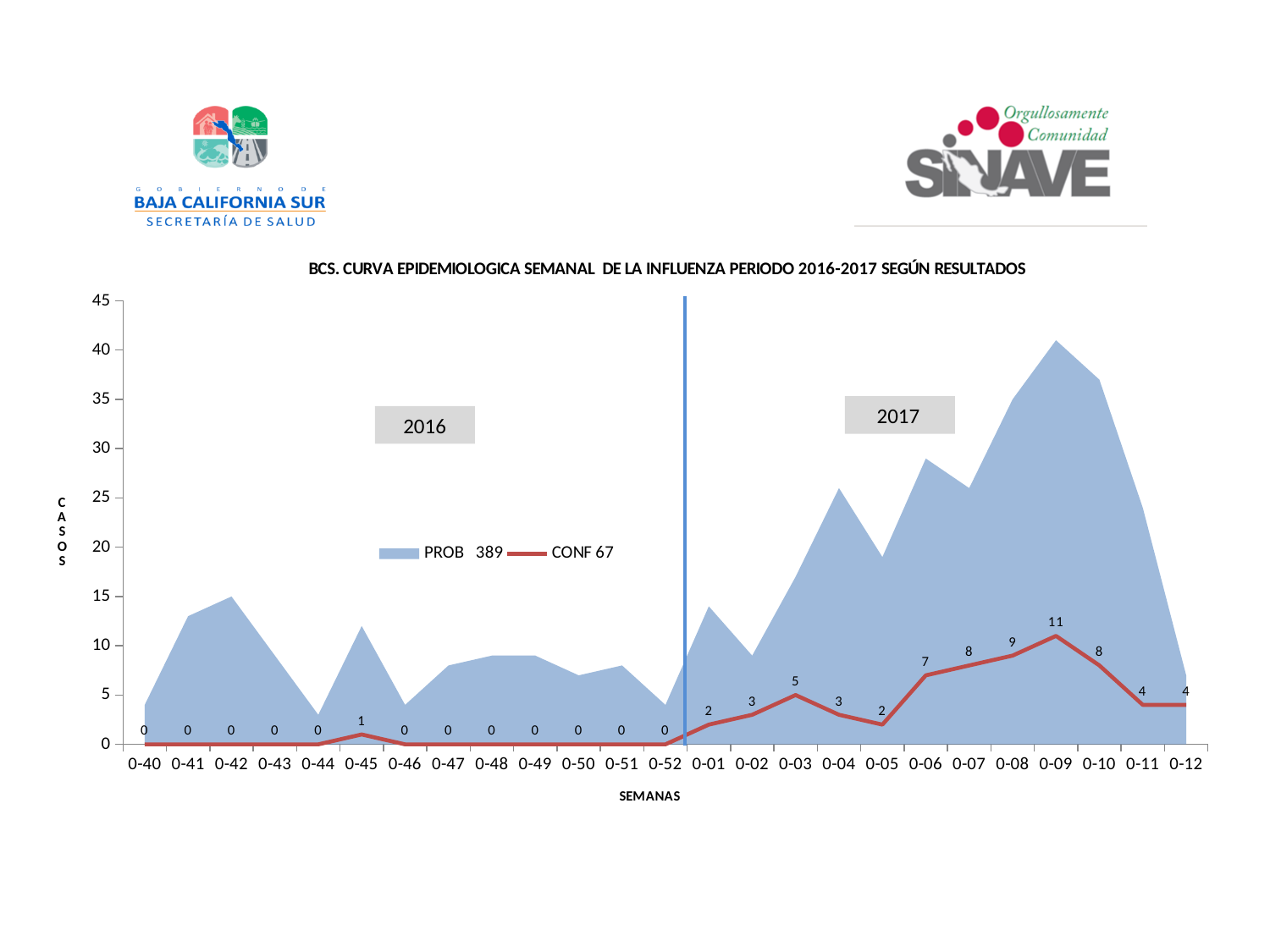
How many weeks are shown on the x axis? 25 How many series does the legend list? 2 Is the PROB value for week 0-44 greater or less than 5? less Does the CONF series rise or fall from week 0-05 to week 0-09? rise What is the CONF value for week 0-03? 5 Is the PROB value for week 0-09 greater or less than 35? greater In which week does the CONF series reach its highest value? 0-09 What is the CONF value for week 0-45? 1 Which week has the larger CONF value, 0-06 or 0-08? 0-08 What is the CONF value for week 0-09? 11 What is the difference between the CONF values for weeks 0-09 and 0-10? 3 What total is shown next to PROB in the legend? 389